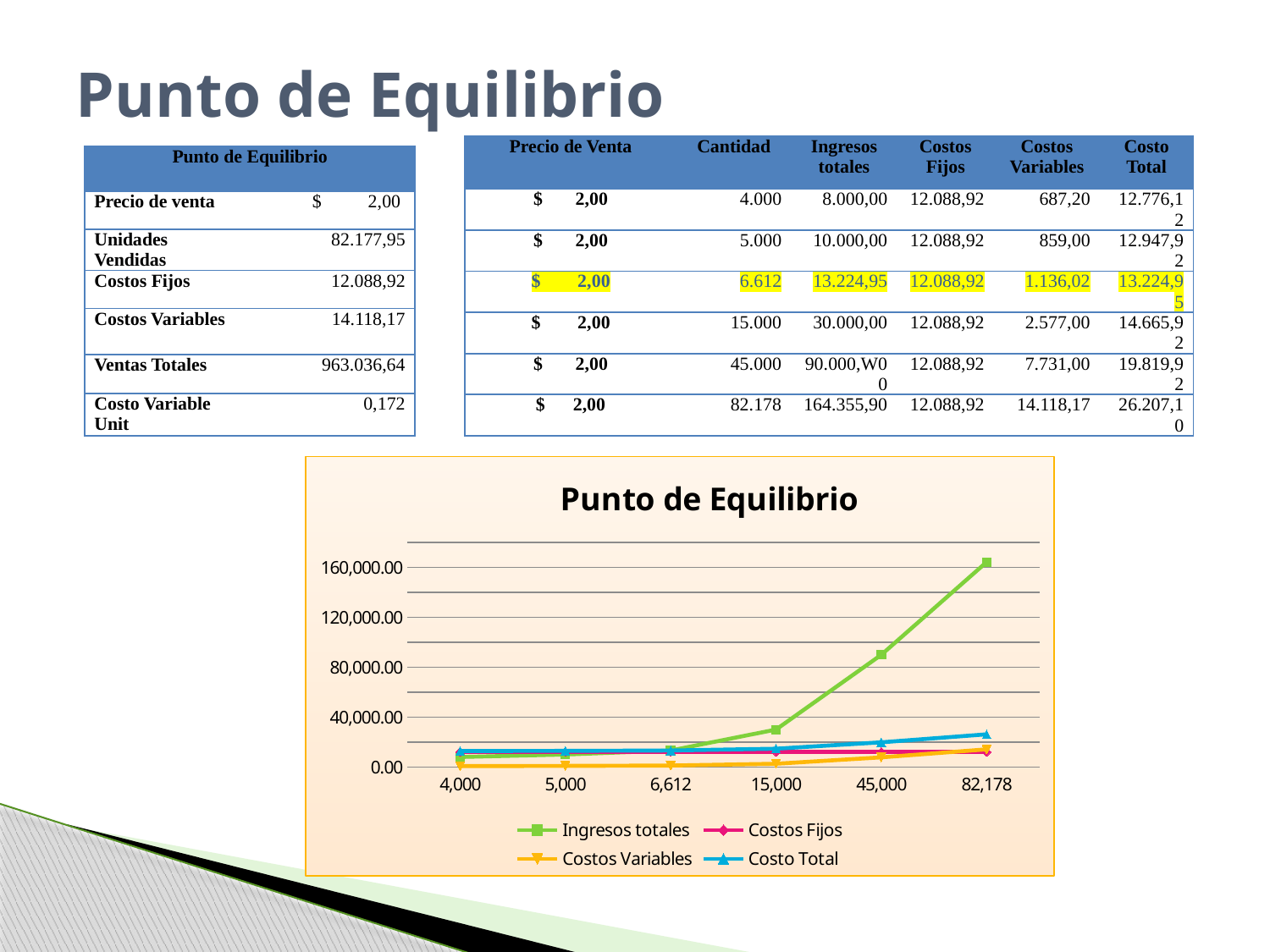
Does Ingresos totales rise or fall as the x-axis categories increase? rise At which x-axis category does Ingresos totales reach its highest value? 82,178 Is the value of Ingresos totales at 45,000 greater or less than 40,000.00? greater Which line is drawn in green on the chart? Ingresos totales At which x-axis category is Ingresos totales lowest? 4,000 Which series has the highest value at the 82,178 category? Ingresos totales How many series does the chart legend list? 4 How many categories are shown on the x axis of the chart? 6 What is the title of the chart? Punto de Equilibrio Is the value of Costo Total at 82,178 greater or less than 40,000.00? less What type of chart is shown on the slide? line chart Is the value of Ingresos totales at 82,178 greater or less than 120,000.00? greater